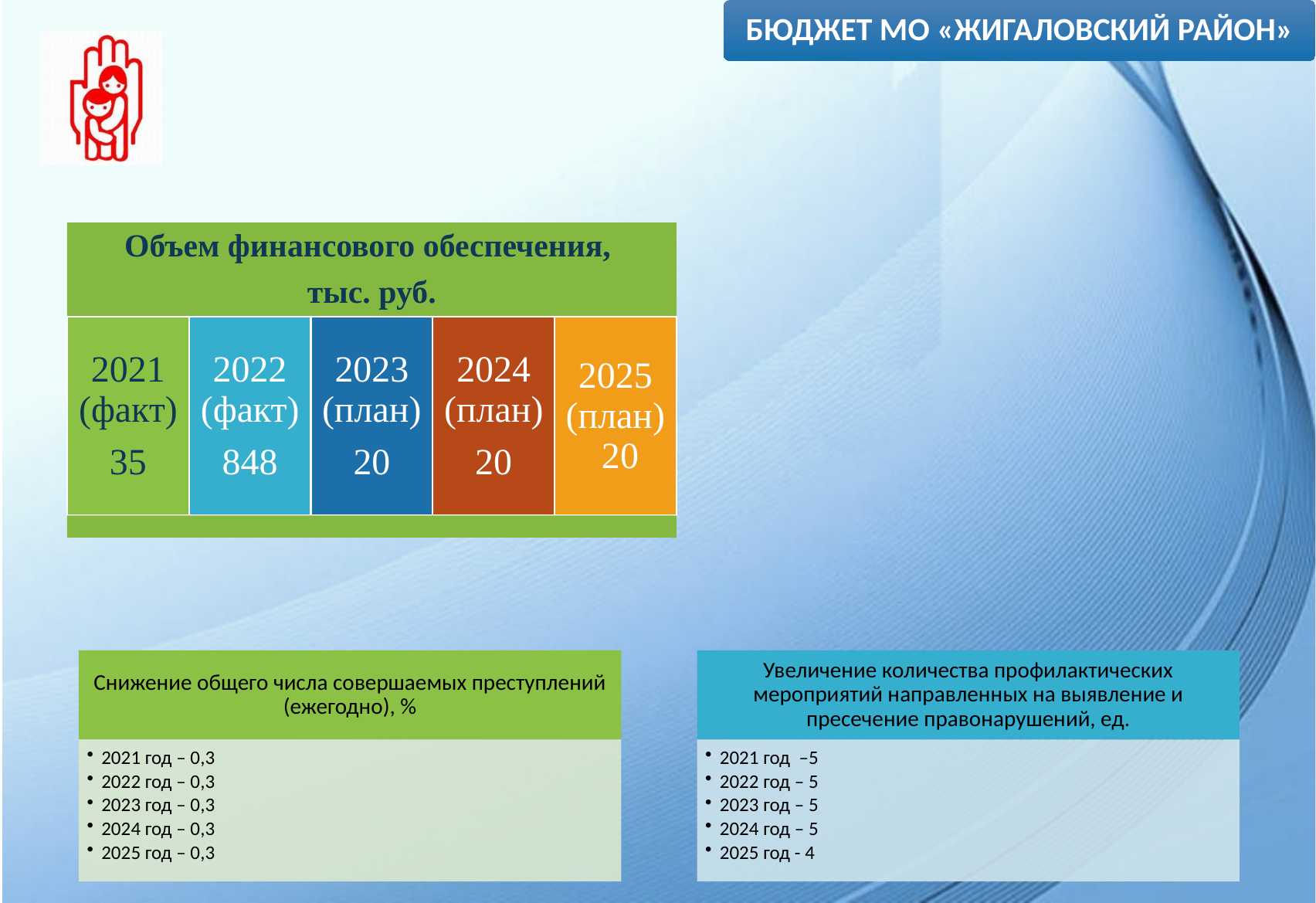
In the table "Объем финансового обеспечения, тыс. руб.", what is the difference between the 2022 (факт) value and the 2021 (факт) value? 813 How many years are shown in the table "Объем финансового обеспечения, тыс. руб."? 5 In the table "Объем финансового обеспечения, тыс. руб.", how many years are marked as (план)? 3 In the table "Объем финансового обеспечения, тыс. руб.", which year has the highest value? 2022 (факт) In the block "Увеличение количества профилактических мероприятий...", what is the value for 2025 год? 4 In the block "Снижение общего числа совершаемых преступлений (ежегодно), %", what is the value for 2023 год? 0,3 What unit is given in the title of the table "Объем финансового обеспечения"? тыс. руб. In the table "Объем финансового обеспечения, тыс. руб.", what is the planned value for 2024? 20 In the table "Объем финансового обеспечения, тыс. руб.", which is larger: the value for 2021 (факт) or the value for 2023 (план)? 2021 (факт) In the table "Объем финансового обеспечения, тыс. руб.", what is the value for 2022 (факт)? 848 In the table "Объем финансового обеспечения, тыс. руб.", what is the value for 2021 (факт)? 35 In the table "Объем финансового обеспечения, тыс. руб.", what is the difference between the 2021 (факт) value and the 2025 (план) value? 15